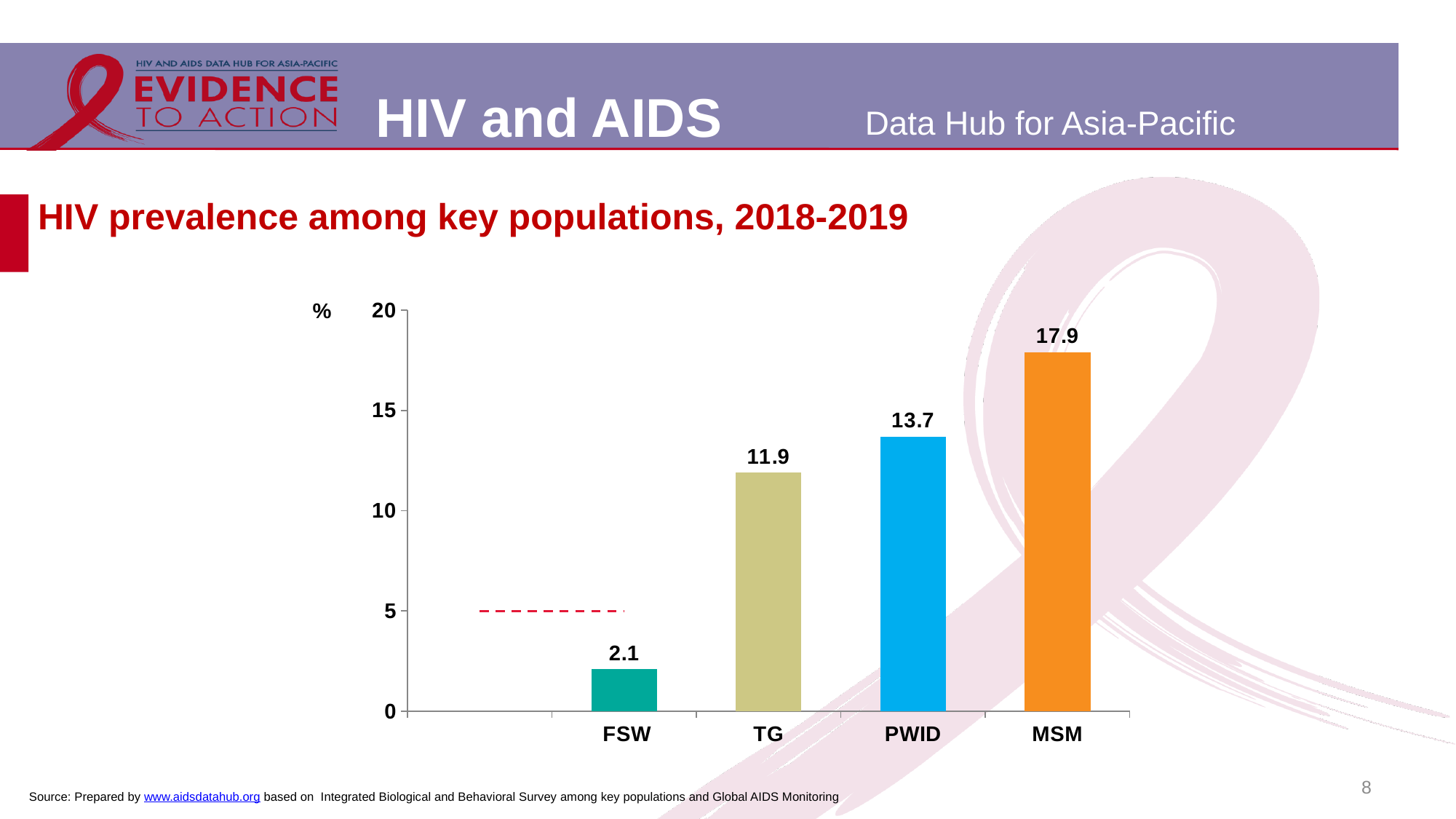
Which key population has the highest HIV prevalence? MSM What is the HIV prevalence value shown for TG? 11.9 How many key populations are shown on the chart? 4 What is the HIV prevalence value shown for FSW? 2.1 What is the HIV prevalence value shown for PWID? 13.7 What is the difference between the HIV prevalence for MSM and for PWID? 4.2 Which has a higher HIV prevalence, TG or PWID? PWID What is the difference between the HIV prevalence for TG and for FSW? 9.8 What is the HIV prevalence value shown for MSM? 17.9 Is the value for MSM greater or less than 15? greater What kind of chart is shown on the slide? Bar chart Which key population has the lowest HIV prevalence? FSW